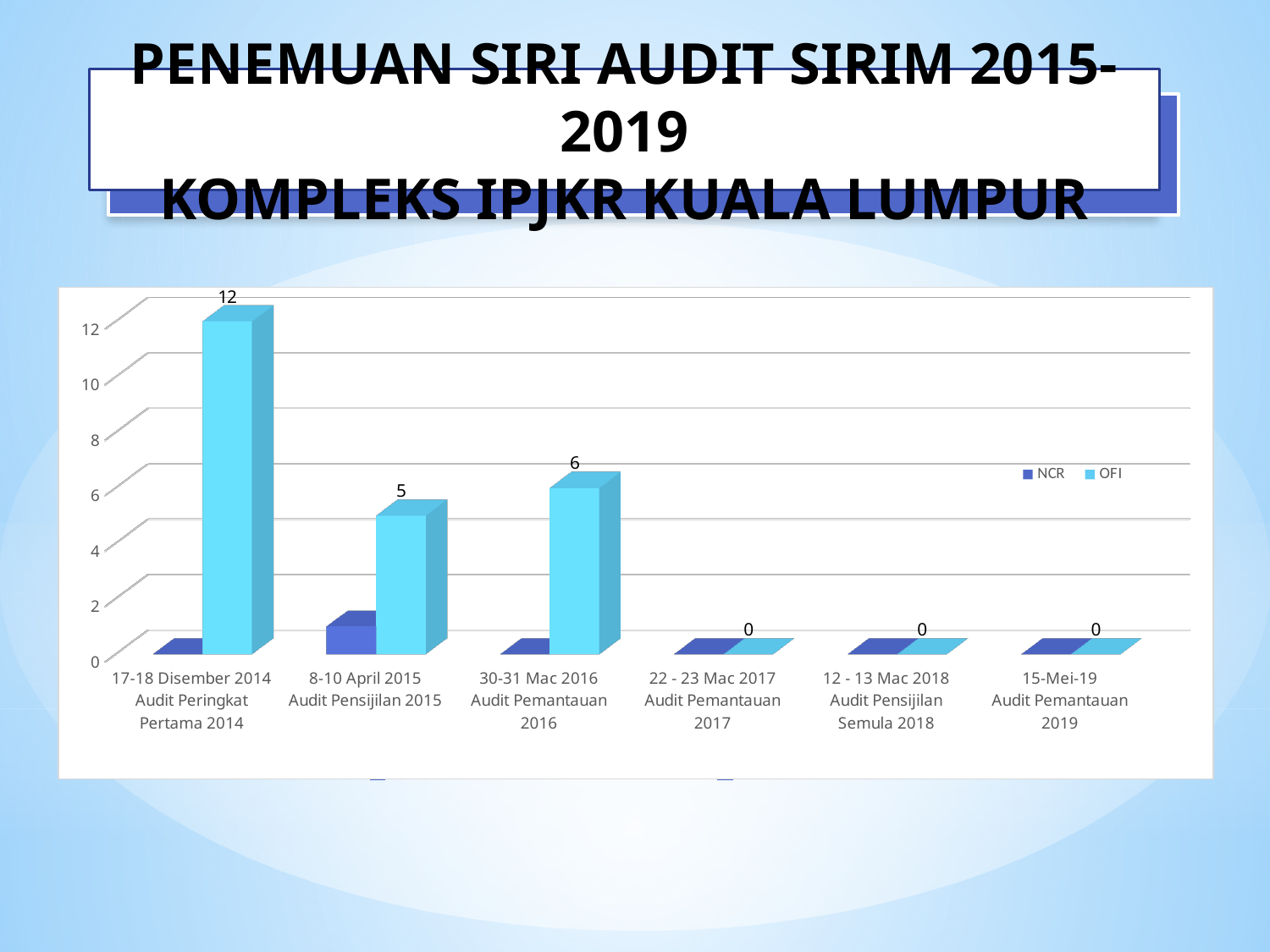
What is the OFI value for 8-10 April 2015 Audit Pensijilan 2015? 5 Which audit has the highest OFI value? 17-18 Disember 2014 Audit Peringkat Pertama 2014 What is the OFI value for 30-31 Mac 2016 Audit Pemantauan 2016? 6 How many series does the legend list? 2 What is the OFI value for 22 - 23 Mac 2017 Audit Pemantauan 2017? 0 Which has the larger OFI value: 8-10 April 2015 Audit Pensijilan 2015 or 30-31 Mac 2016 Audit Pemantauan 2016? 30-31 Mac 2016 Audit Pemantauan 2016 What kind of chart is shown on the slide? bar chart What is the difference between the OFI values for 30-31 Mac 2016 Audit Pemantauan 2016 and 8-10 April 2015 Audit Pensijilan 2015? 1 Is the OFI value for 17-18 Disember 2014 Audit Peringkat Pertama 2014 greater or less than 10? greater What is the difference between the OFI value for 17-18 Disember 2014 Audit Peringkat Pertama 2014 and the OFI value for 30-31 Mac 2016 Audit Pemantauan 2016? 6 What is the OFI value for 17-18 Disember 2014 Audit Peringkat Pertama 2014? 12 How many audit categories are shown on the x axis? 6